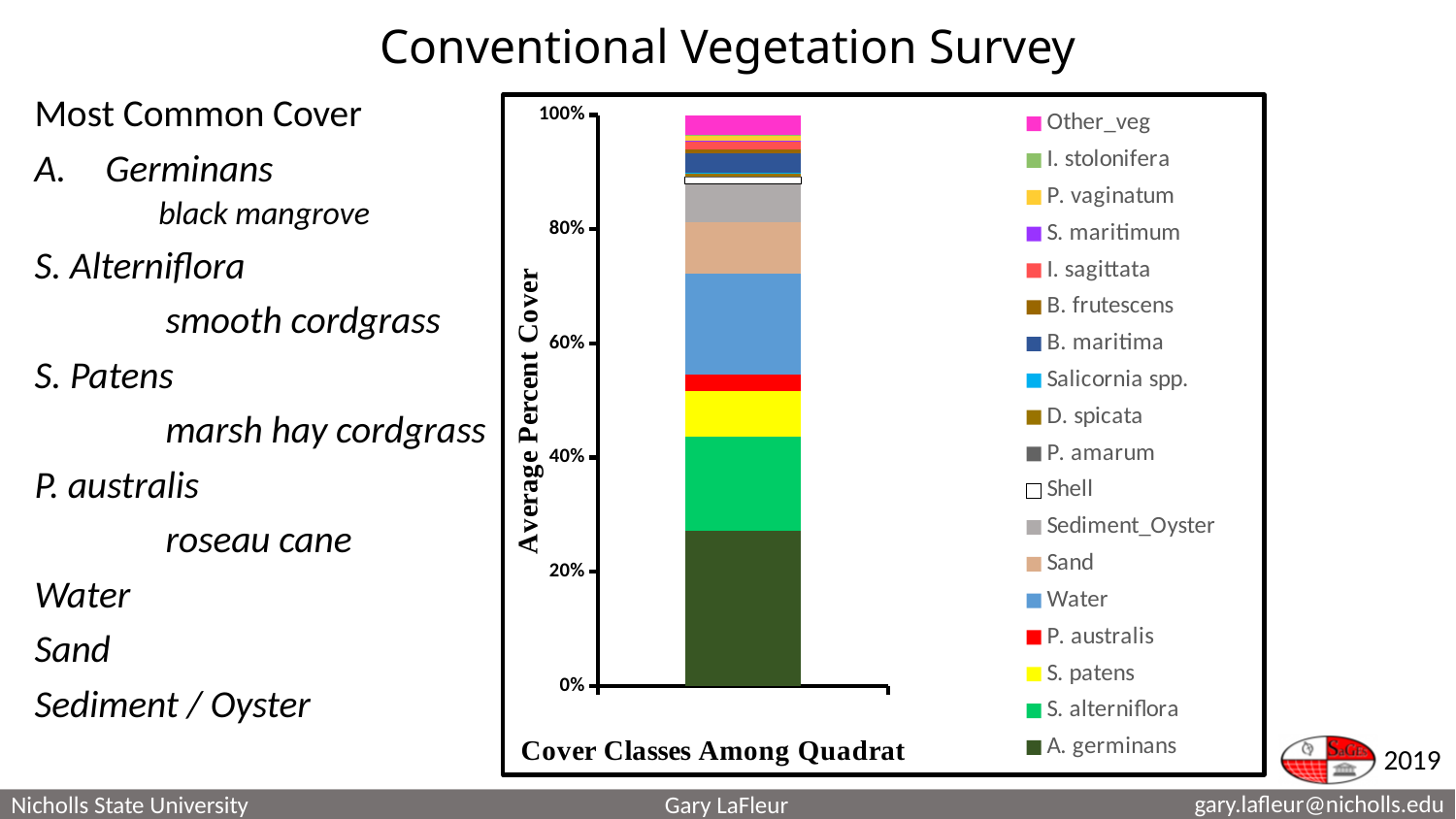
Which is larger, the A. germinans segment or the S. alterniflora segment? A. germinans Is the value for A. germinans greater or less than 40%? less How many bars are plotted in the chart? 1 What is the total height of the stacked bar? 100% Is the value for A. germinans greater or less than 20%? greater Which series occupies the largest portion of the stacked bar? A. germinans Which is larger, the Water segment or the S. patens segment? Water What is the label on the chart's vertical axis? Average Percent Cover What kind of chart is shown on the slide? Stacked bar chart Is the value for S. patens greater or less than 20%? less What is the title of the chart? Cover Classes Among Quadrat How many series does the chart's legend list? 18